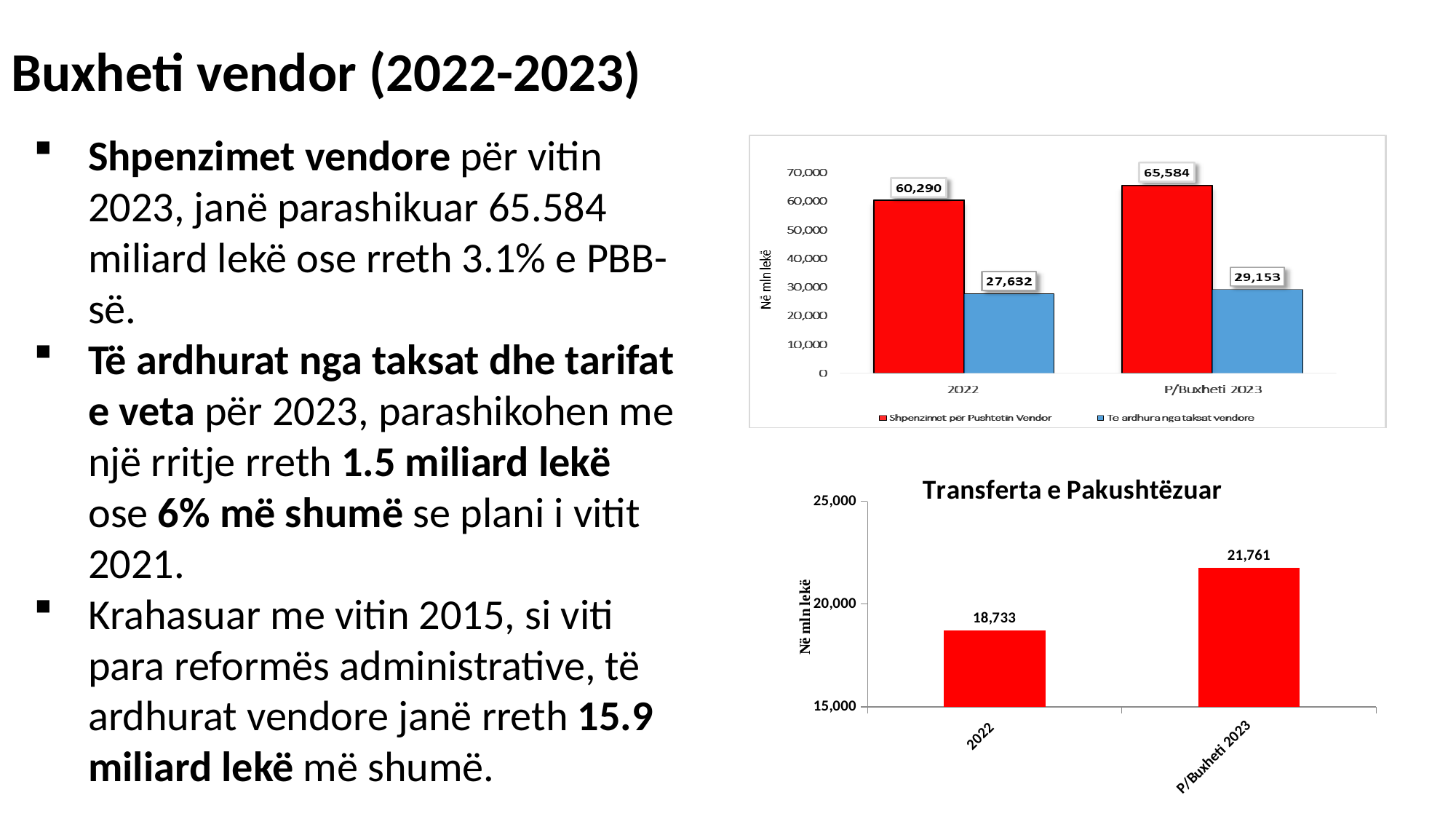
What kind of chart is the chart titled Transferta e Pakushtëzuar? bar chart In the top chart, how many series does the legend list? 2 In the chart titled Transferta e Pakushtëzuar, is the value for 2022 greater or less than 20,000? less In the top chart, by how much does Shpenzimet për Pushtetin Vendor increase from 2022 to P/Buxheti 2023? 5,294 In the chart titled Transferta e Pakushtëzuar, what is the difference between P/Buxheti 2023 and 2022? 3,028 In the top chart, what is the value of Shpenzimet për Pushtetin Vendor for 2022? 60,290 In the top chart, what is the value of Te ardhura nga taksat vendore for P/Buxheti 2023? 29,153 In the top chart, what is the value of Shpenzimet për Pushtetin Vendor for P/Buxheti 2023? 65,584 In the top chart, which series has the higher value in 2022? Shpenzimet për Pushtetin Vendor In the top chart, what is the difference between Te ardhura nga taksat vendore in P/Buxheti 2023 and in 2022? 1,521 In the chart titled Transferta e Pakushtëzuar, what is the value for 2022? 18,733 In the chart titled Transferta e Pakushtëzuar, what is the value for P/Buxheti 2023? 21,761